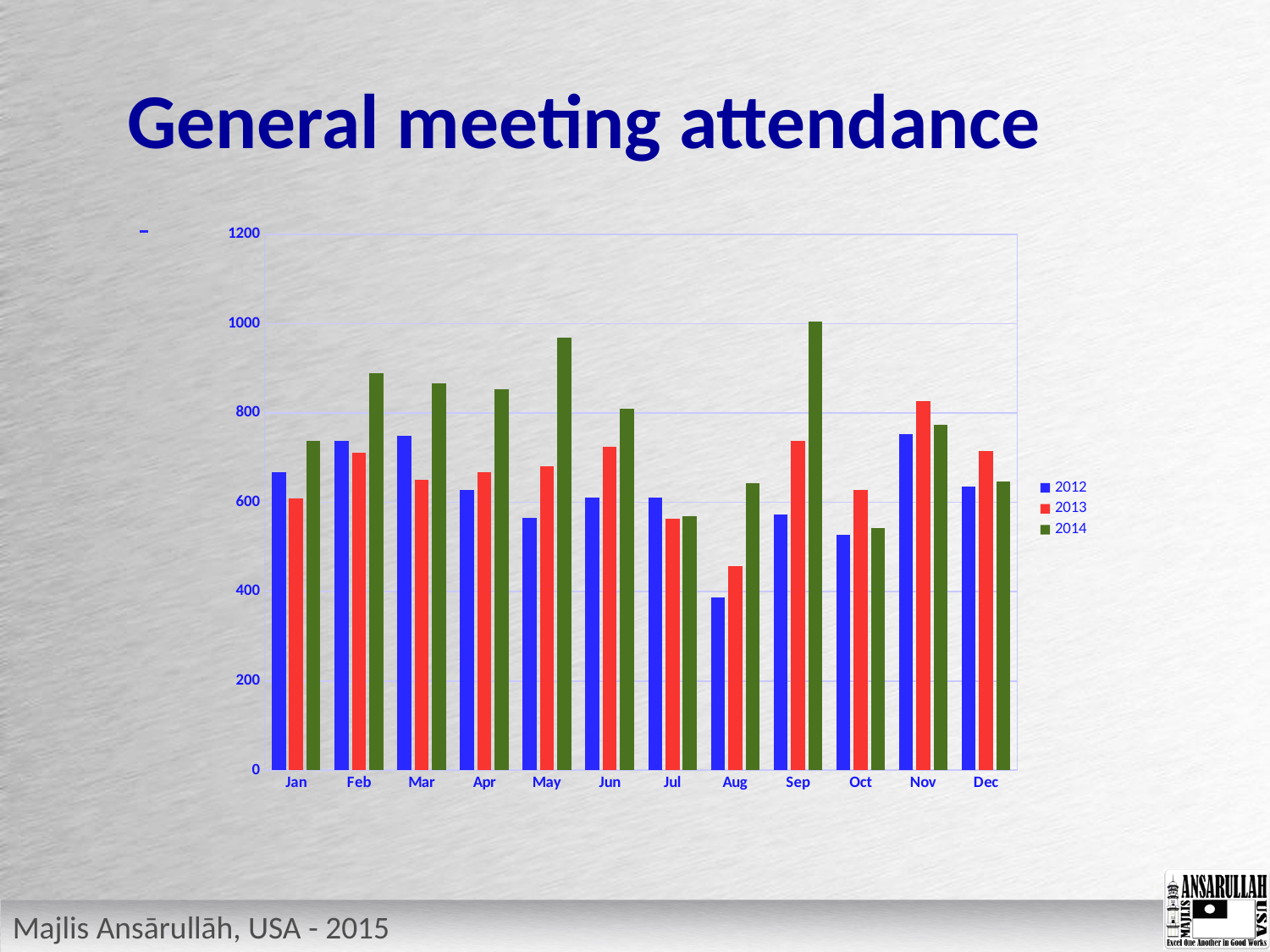
In Oct, which series has the larger value, 2013 or 2014? 2013 Which month has the lowest value for the 2012 series? Aug Is the value for 2013 in Nov greater or less than 800? greater Is the value for 2014 in May greater or less than 800? greater In Jan, which series has the larger value, 2012 or 2014? 2014 What is the title of the chart on the slide? General meeting attendance How many months are shown along the x axis? 12 Which month has the highest value for the 2014 series? Sep What kind of chart is shown on the slide? Bar chart How many series does the legend list? 3 Is the value for 2012 in Aug greater or less than 400? less Which month has the highest value for the 2013 series? Nov